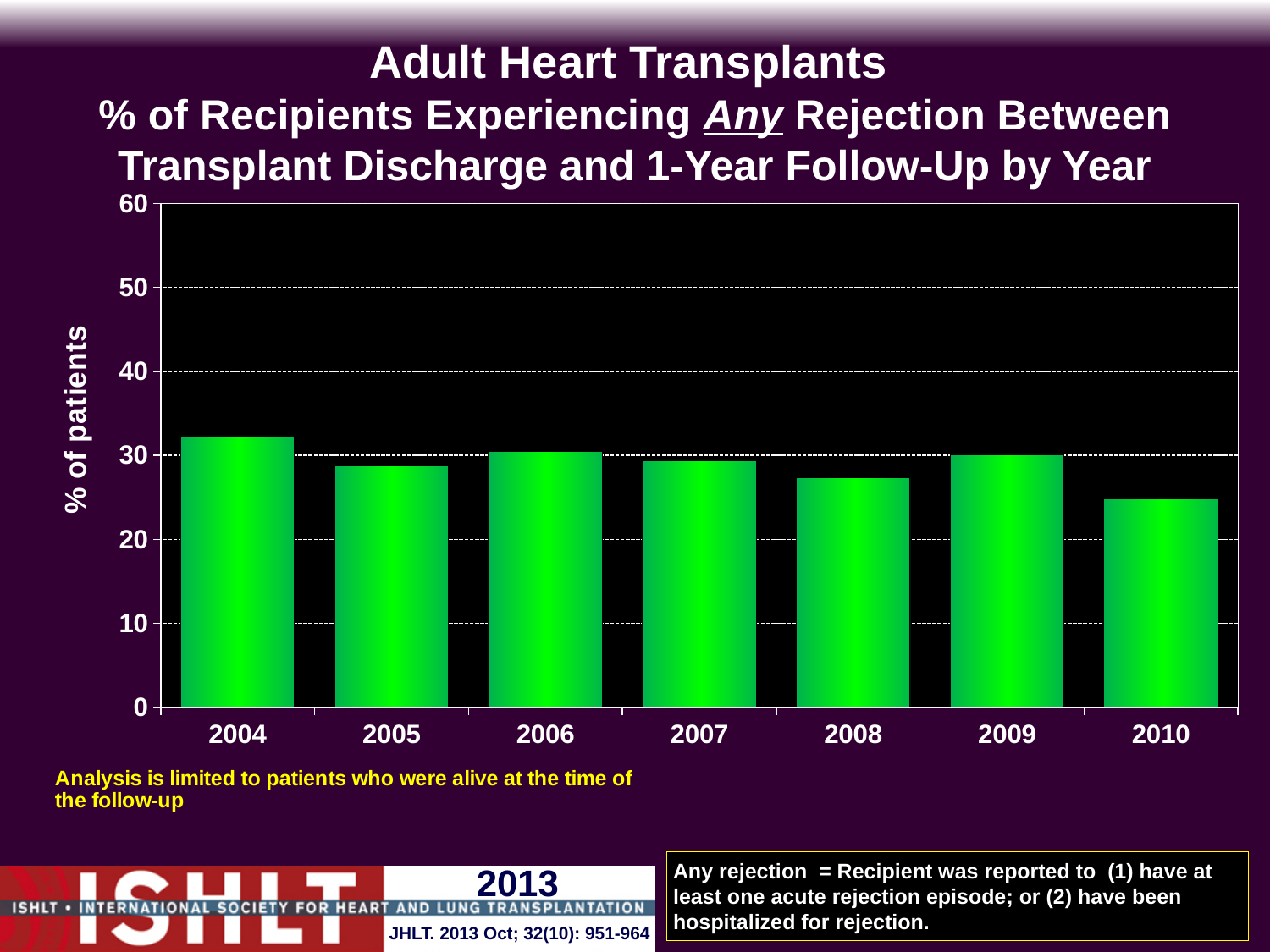
What is the label on the y axis of the chart? % of patients Which year has the lowest percentage of recipients experiencing any rejection? 2010 Is the value for 2004 greater or less than 30? greater Is the value for 2008 greater or less than 30? less Overall, do the values rise or fall from 2004 to 2010? fall Is the value for 2010 greater or less than 30? less How many years are shown on the x axis of the chart? 7 What kind of chart is shown on the slide? bar chart Which year has the highest percentage of recipients experiencing any rejection? 2004 Which year has a larger value, 2004 or 2010? 2004 Which year has a larger value, 2006 or 2008? 2006